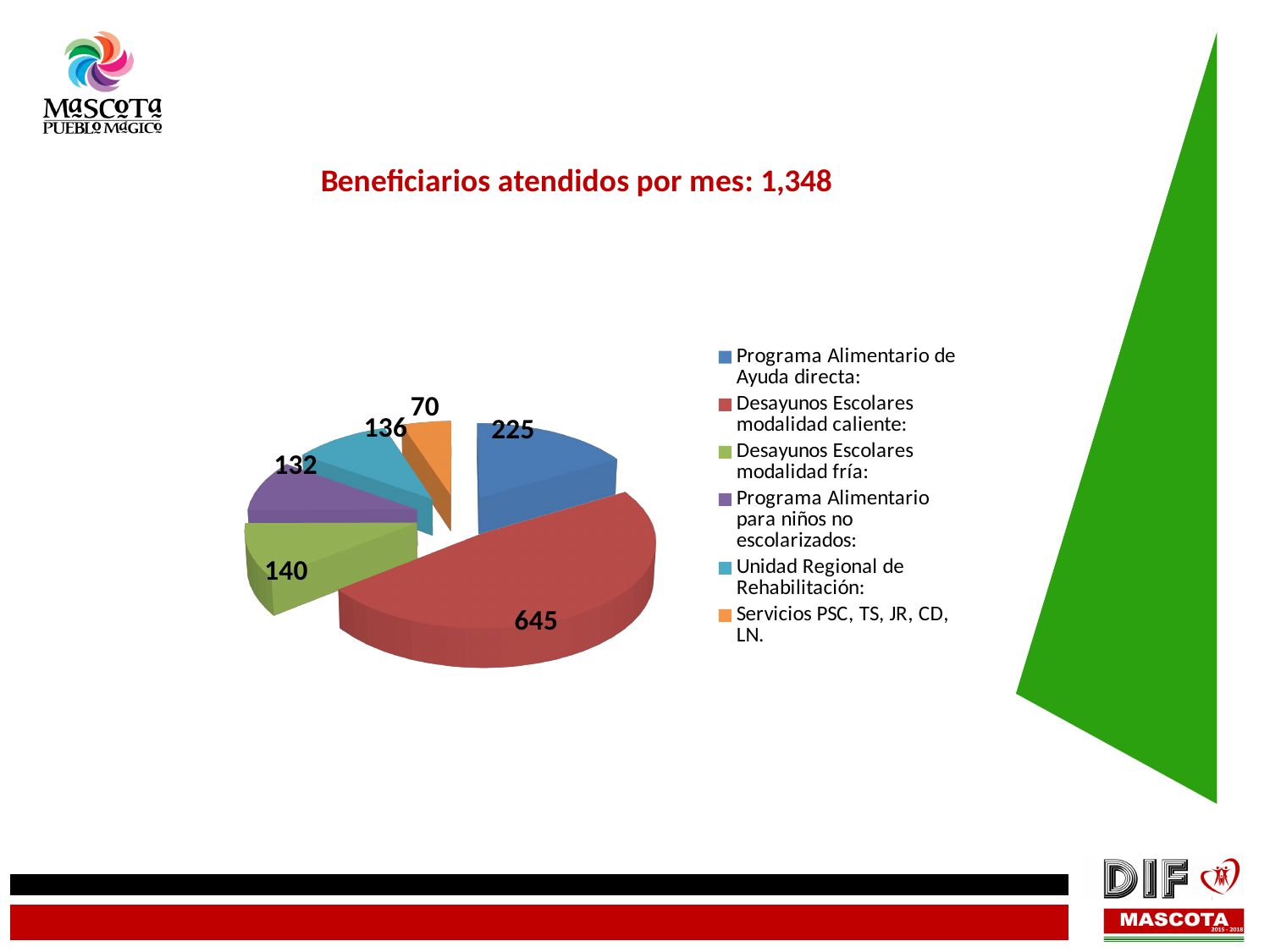
Which is larger: Desayunos Escolares modalidad fría or Programa Alimentario para niños no escolarizados? Desayunos Escolares modalidad fría Which category has the smallest slice of the pie? Servicios PSC, TS, JR, CD, LN. Which category has the largest slice of the pie? Desayunos Escolares modalidad caliente What is the value for Programa Alimentario de Ayuda directa? 225 How many categories does the pie chart have? 6 What is the title of the chart? Beneficiarios atendidos por mes: 1,348 What is the value for Unidad Regional de Rehabilitación? 136 What is the difference between the values for Desayunos Escolares modalidad caliente and Programa Alimentario de Ayuda directa? 420 What is the value for Desayunos Escolares modalidad caliente? 645 What is the total of all the slices in the pie chart? 1,348 What type of chart is shown on the slide? pie chart What is the value for Servicios PSC, TS, JR, CD, LN.? 70